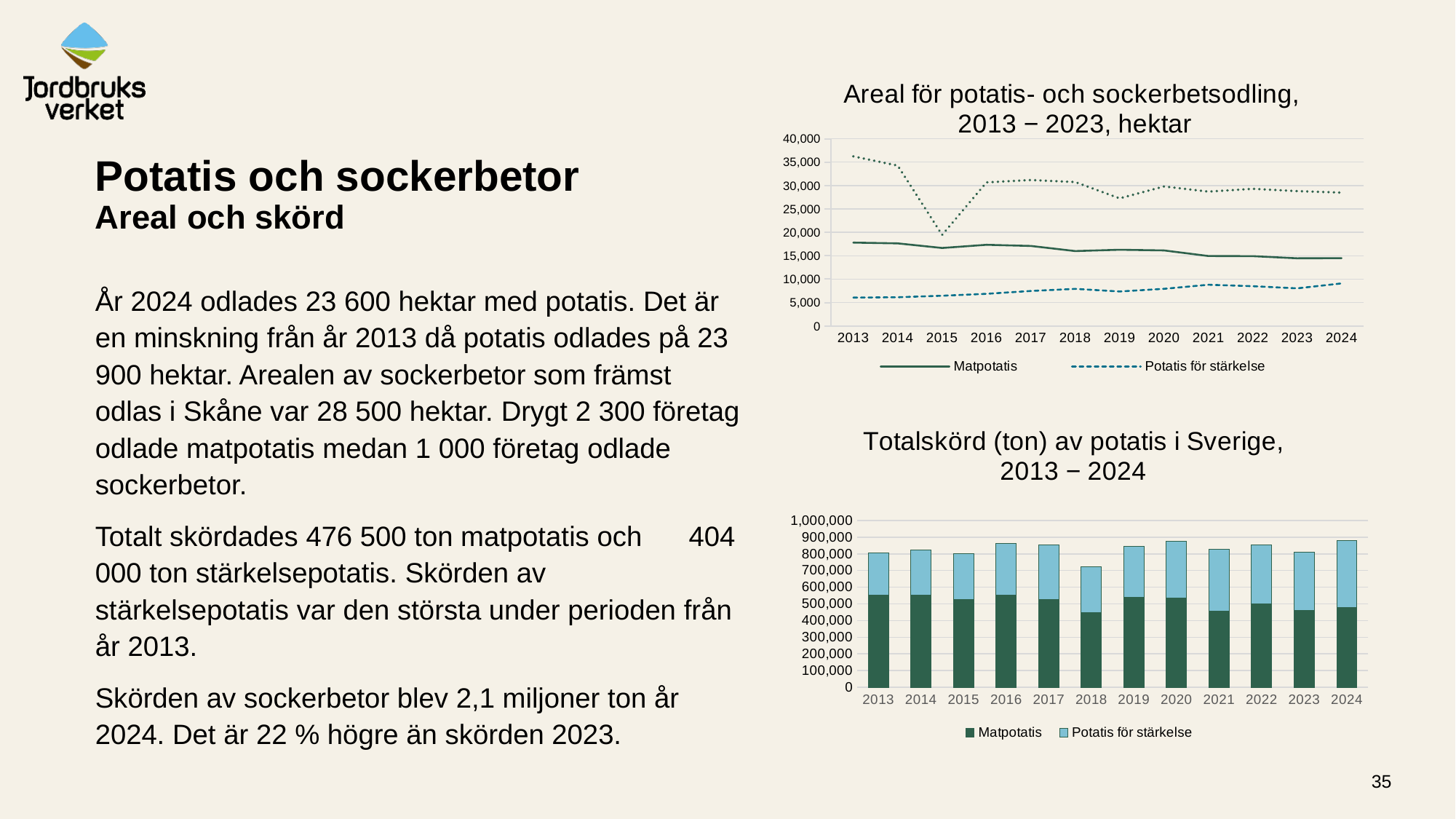
In the chart "Totalskörd (ton) av potatis i Sverige, 2013 − 2024", how many series does the legend list? 2 What kind of chart is the chart titled "Totalskörd (ton) av potatis i Sverige, 2013 − 2024"? stacked bar chart In the chart "Totalskörd (ton) av potatis i Sverige, 2013 − 2024", is the Matpotatis value for 2018 greater or less than 500,000? less In the chart "Totalskörd (ton) av potatis i Sverige, 2013 − 2024", which series is shown in dark green? Matpotatis In the chart "Areal för potatis- och sockerbetsodling, 2013 − 2023, hektar", does the Matpotatis line rise or fall from 2013 to 2024? fall In the chart "Areal för potatis- och sockerbetsodling, 2013 − 2023, hektar", which is larger in 2024, Matpotatis or Potatis för stärkelse? Matpotatis In the chart "Totalskörd (ton) av potatis i Sverige, 2013 − 2024", is the total for 2018 greater or less than 800,000? less In the chart "Totalskörd (ton) av potatis i Sverige, 2013 − 2024", how many years are shown on the x axis? 12 In the chart "Areal för potatis- och sockerbetsodling, 2013 − 2023, hektar", is the value for Matpotatis in 2013 greater or less than 15,000? greater In the chart "Totalskörd (ton) av potatis i Sverige, 2013 − 2024", which year has the lowest total harvest? 2018 What kind of chart is the chart titled "Areal för potatis- och sockerbetsodling, 2013 − 2023, hektar"? line chart